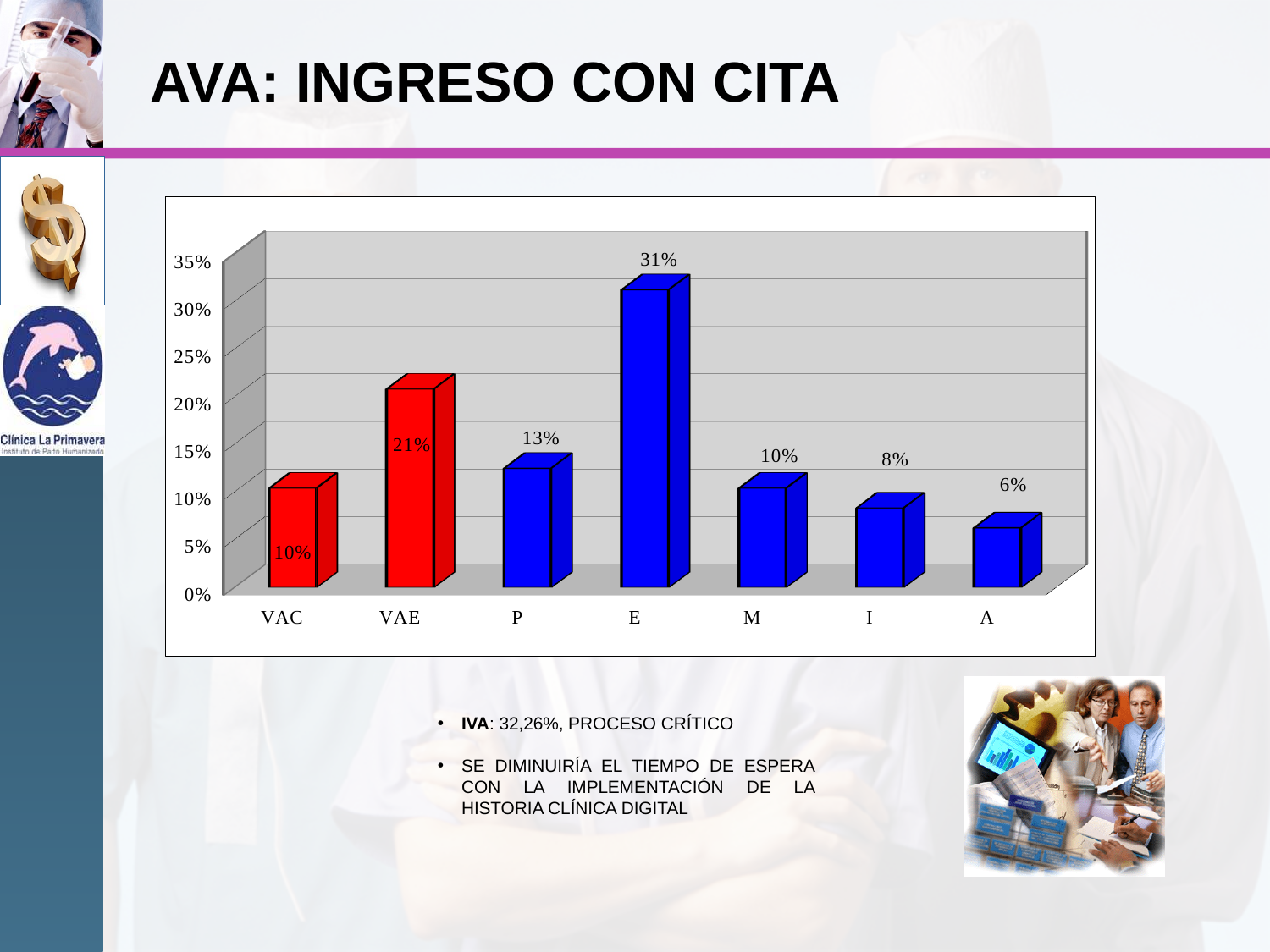
Which category has the lowest value? A What is the value for A? 6% What is the value for E? 31% Which categories are shown with red bars? VAC and VAE What is the value for VAE? 21% What kind of chart is shown on the slide? Bar chart Which is larger, the value for P or the value for I? P What is the value for M? 10% What is the difference between the values for VAE and VAC? 11% Which category has the highest value? E How many categories are shown on the x axis? 7 What is the difference between the values for E and P? 18%